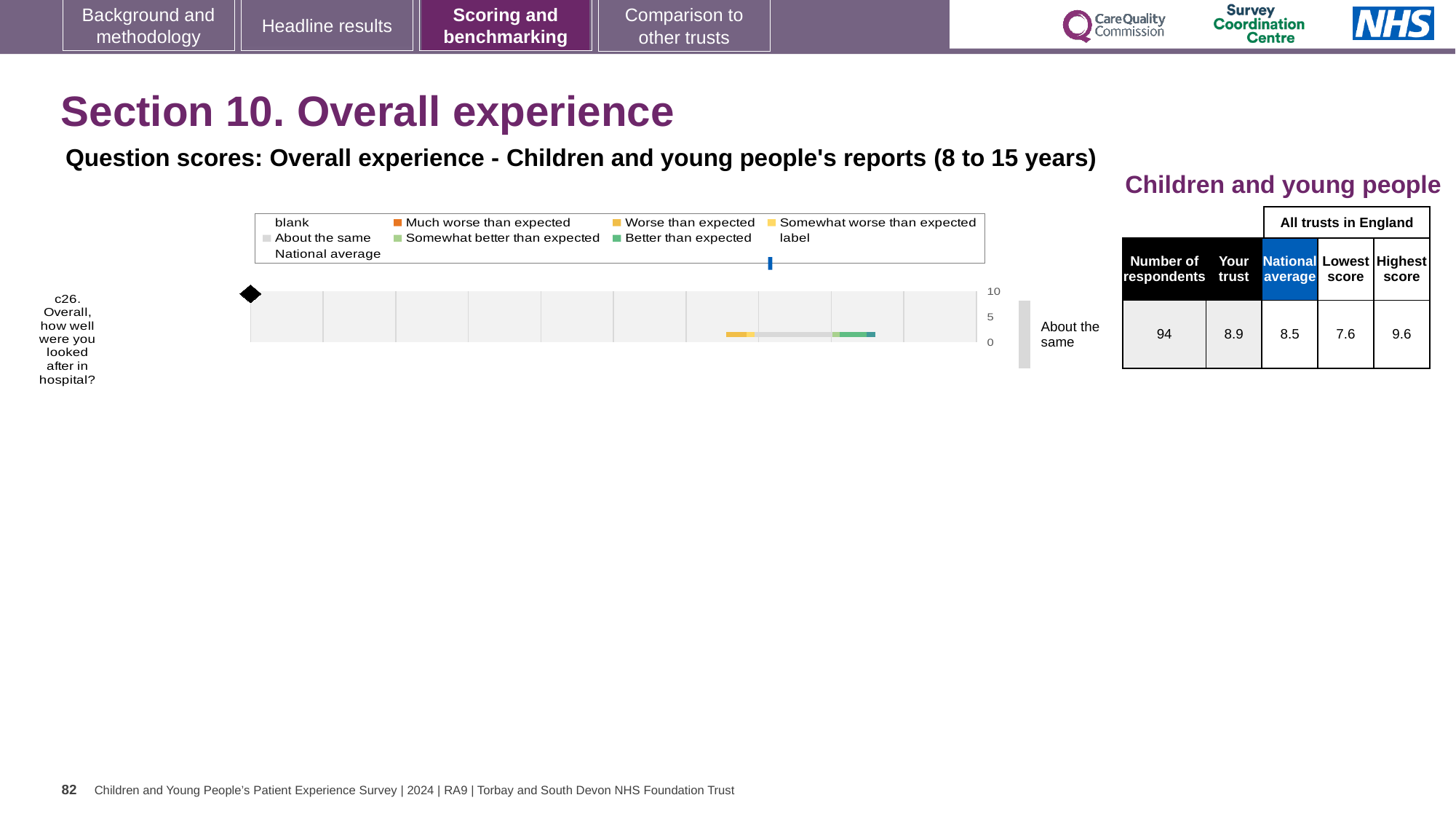
Is the 'Your trust' score for c26 greater or less than 5? greater What is the 'Your trust' score for question c26 (Overall, how well were you looked after in hospital?)? 8.9 What benchmark category label is shown next to the chart for question c26? About the same What is the highest score among all trusts in England for question c26? 9.6 What is the lowest score among all trusts in England for question c26? 7.6 How many questions (categories) are plotted on the chart? 1 What is the national average score shown for question c26? 8.5 Is the 'Your trust' score for c26 higher or lower than the national average? higher What is the difference between the 'Your trust' score and the national average for c26? 0.4 What is the maximum value shown on the chart's score axis? 10 How many respondents answered question c26? 94 What is the difference between the highest and lowest scores among all trusts in England for c26? 2.0